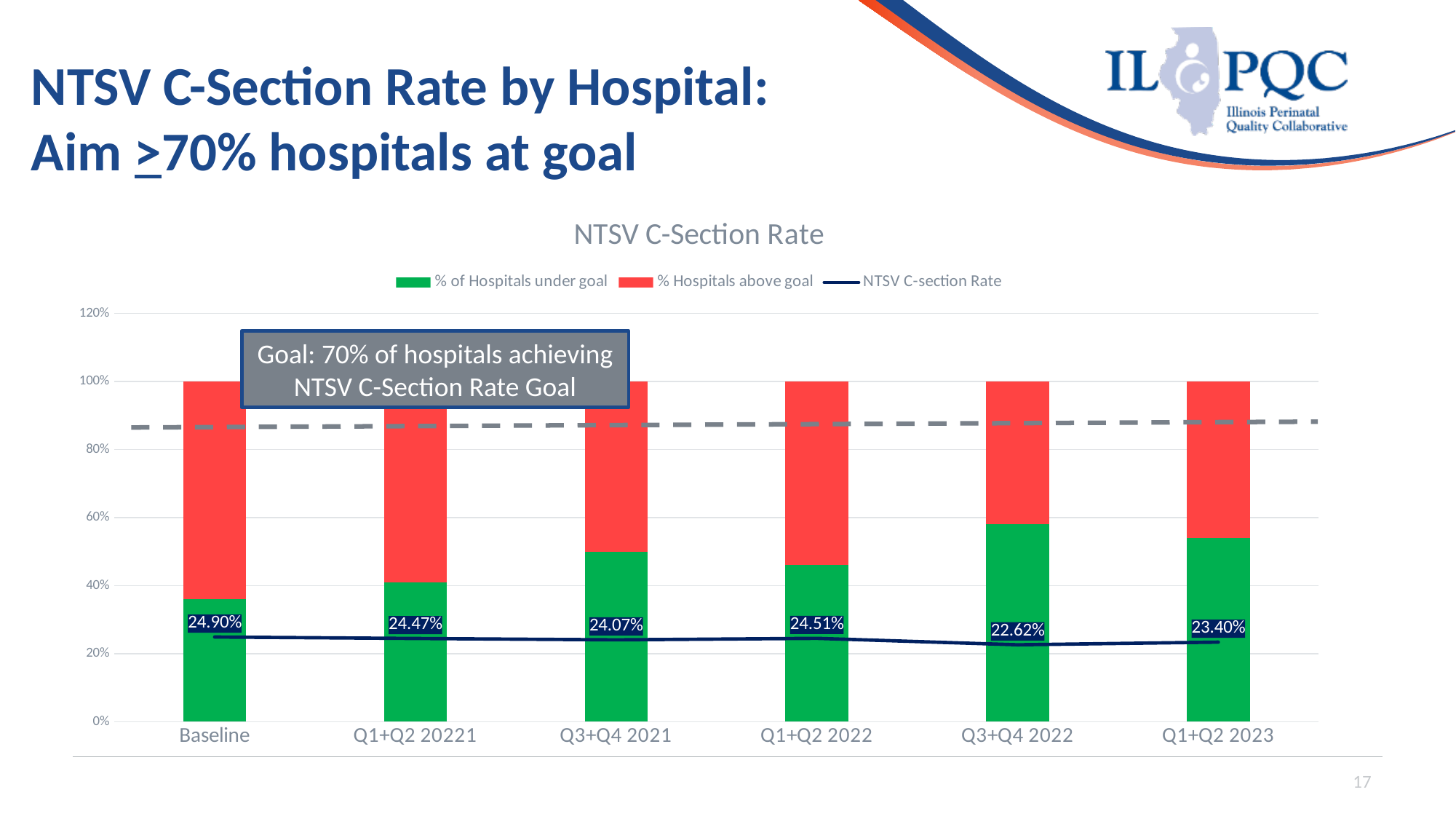
Which has a higher NTSV C-section Rate, Q3+Q4 2021 or Q1+Q2 2022? Q1+Q2 2022 Is the % of Hospitals under goal for Baseline greater or less than 40%? less Which period has the highest NTSV C-section Rate? Baseline Which period has the lowest NTSV C-section Rate? Q3+Q4 2022 What is the difference between the NTSV C-section Rate at Baseline and at Q3+Q4 2022? 2.28 percentage points What is the NTSV C-section Rate for Q3+Q4 2022? 22.62% How many periods are shown on the x axis? 6 How many series does the legend list? 3 What is the NTSV C-section Rate for Q1+Q2 2023? 23.40% What is the total of the stacked bar for Q1+Q2 2023? 100% What is the NTSV C-section Rate for Baseline? 24.90% Is the % of Hospitals under goal for Q3+Q4 2022 greater or less than 40%? greater